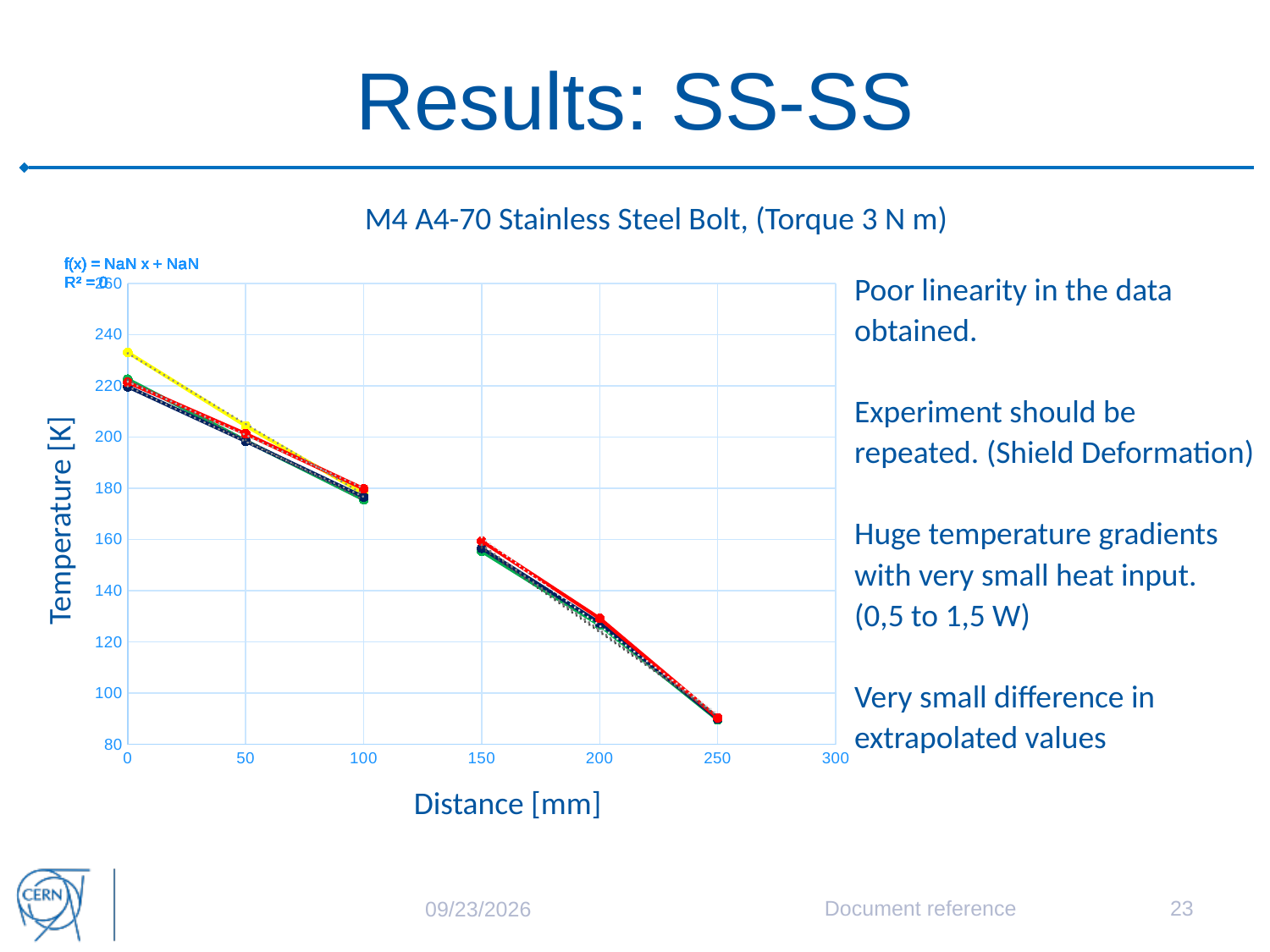
Is the temperature at a distance of 0 mm greater or less than 200 K? greater What kind of chart is shown on the slide? line chart What is the label of the vertical axis of the chart? Temperature [K] Is the temperature at a distance of 100 mm greater or less than 200 K? less Is the temperature at a distance of 250 mm greater or less than 100 K? less Do the temperature values rise or fall as distance increases along the x axis? fall What is the title of the chart? M4 A4-70 Stainless Steel Bolt, (Torque 3 N m) At how many distance positions are data points plotted on the chart? 6 Which distance has the lowest temperature values on the chart? 250 Which distance has the highest temperature values on the chart? 0